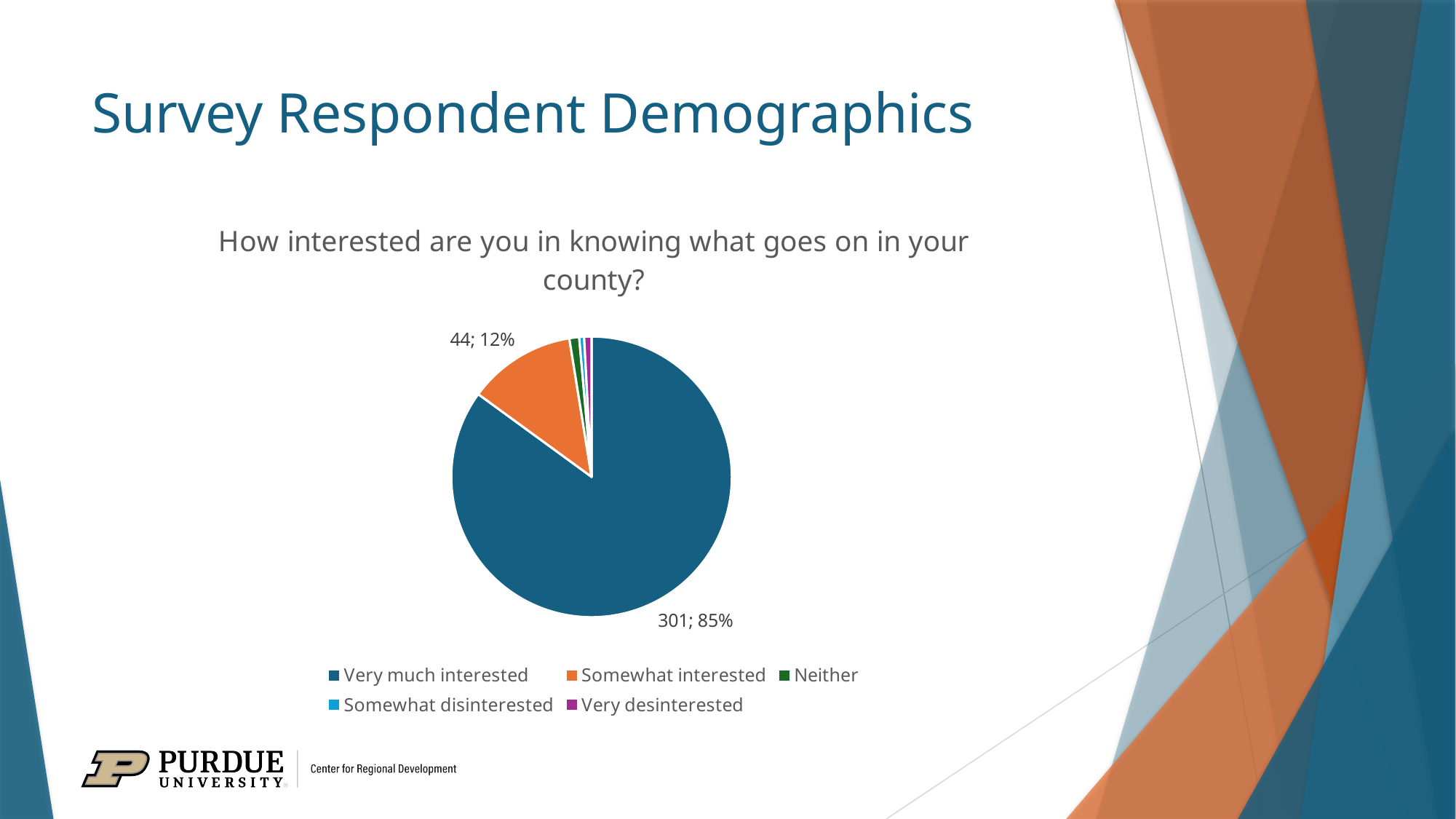
What is the difference between the number of "Very much interested" and "Somewhat interested" respondents? 257 How many respondents answered "Very much interested"? 301 How many respondents answered "Somewhat interested"? 44 How many response categories does the legend list? 5 Which colour represents "Somewhat interested" in the pie chart? orange What share of the pie does "Somewhat interested" represent? 12% Which is larger, the count for "Very much interested" or for "Somewhat interested"? Very much interested Which response category has the largest slice of the pie? Very much interested What kind of chart is shown on the slide? pie chart How many categories are shown in the pie chart? 5 What share of the pie does "Very much interested" represent? 85% What is the chart's title? How interested are you in knowing what goes on in your county?